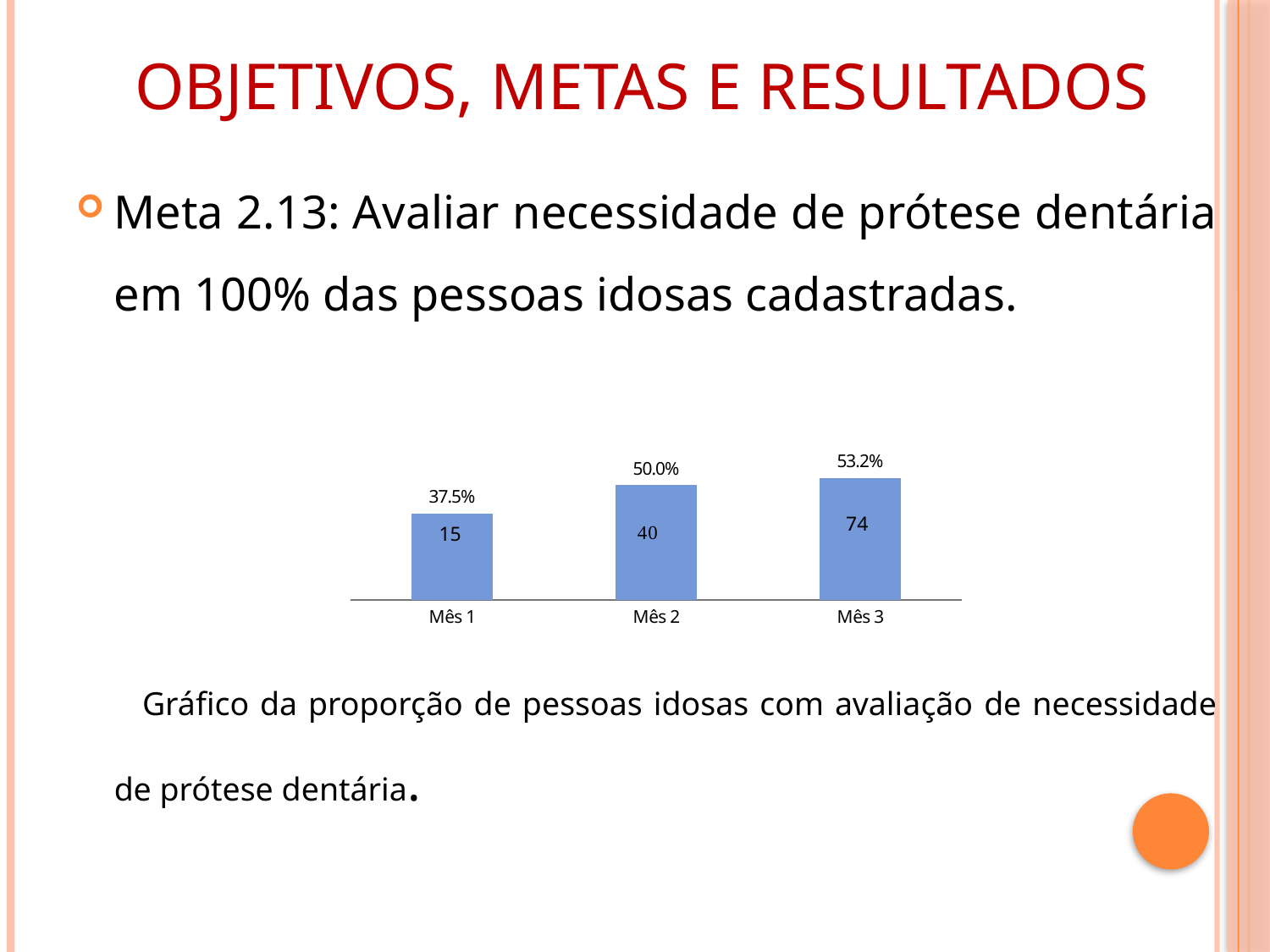
Which month has the lowest percentage? Mês 1 What percentage is shown above the bar for Mês 1? 37.5% What number is printed inside the bar for Mês 1? 15 What percentage is shown above the bar for Mês 3? 53.2% What kind of chart is shown on the slide? Bar chart Which month has the highest percentage? Mês 3 Which is larger, the percentage for Mês 1 or for Mês 2? Mês 2 What is the difference in percentage points between Mês 2 and Mês 1? 12.5 How many months are shown on the x axis? 3 What percentage is shown above the bar for Mês 2? 50.0% What is the difference between the numbers printed inside the bars for Mês 3 and Mês 2? 34 What number is printed inside the bar for Mês 3? 74